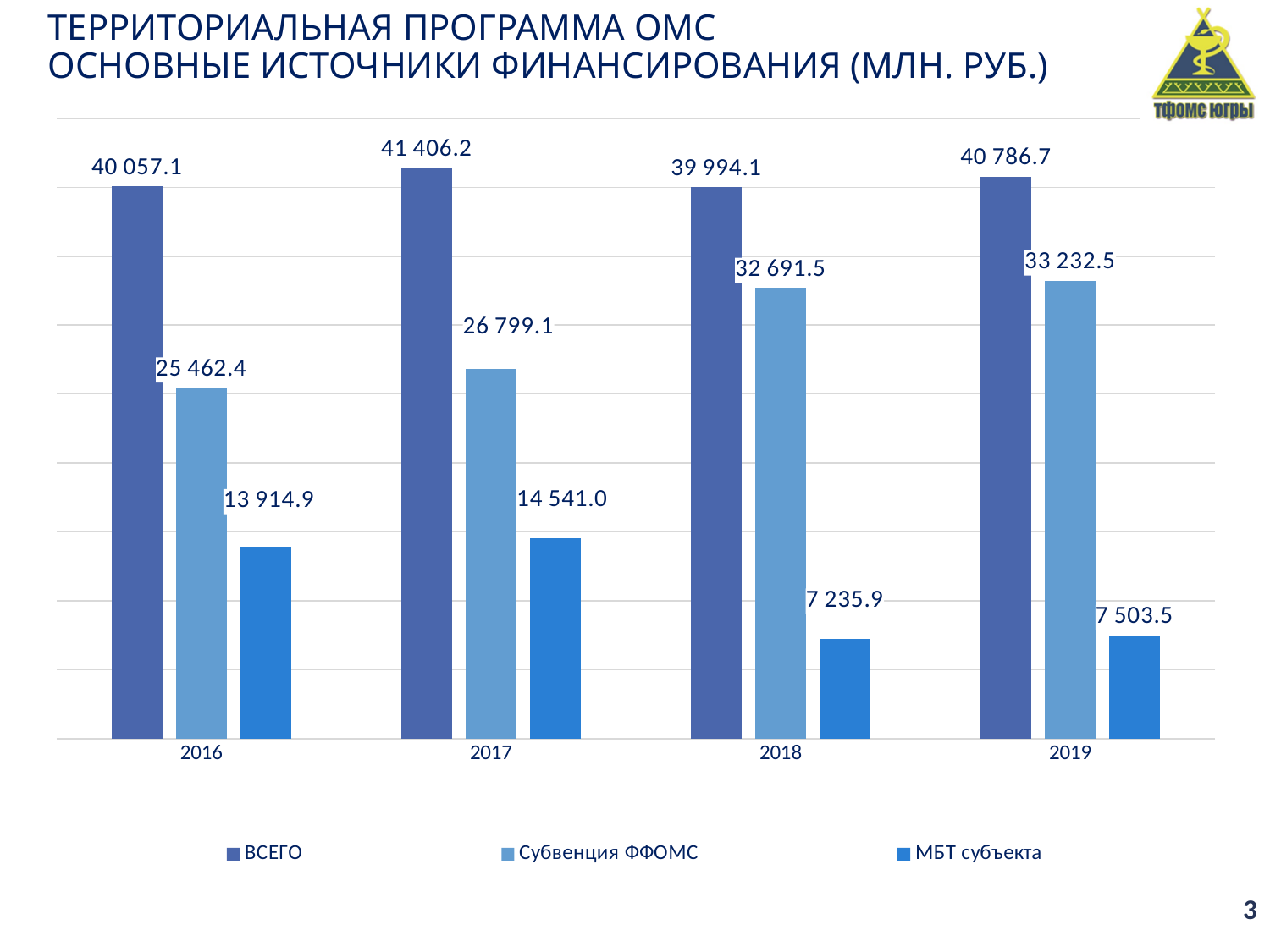
What is the value of МБТ субъекта for 2019? 7 503.5 In which year is МБТ субъекта the lowest? 2018 What is the difference between ВСЕГО in 2017 and ВСЕГО in 2016? 1 349.1 How many series does the legend list? 3 What is the difference between Субвенция ФФОМС in 2019 and in 2018? 541.0 In which year is ВСЕГО the lowest? 2018 Which is larger: МБТ субъекта in 2016 or МБТ субъекта in 2017? 2017 Does Субвенция ФФОМС rise or fall from 2016 to 2019? rise What is the value of Субвенция ФФОМС for 2018? 32 691.5 In which year is ВСЕГО the highest? 2017 What is the value of МБТ субъекта for 2016? 13 914.9 What is the value of ВСЕГО for 2017? 41 406.2